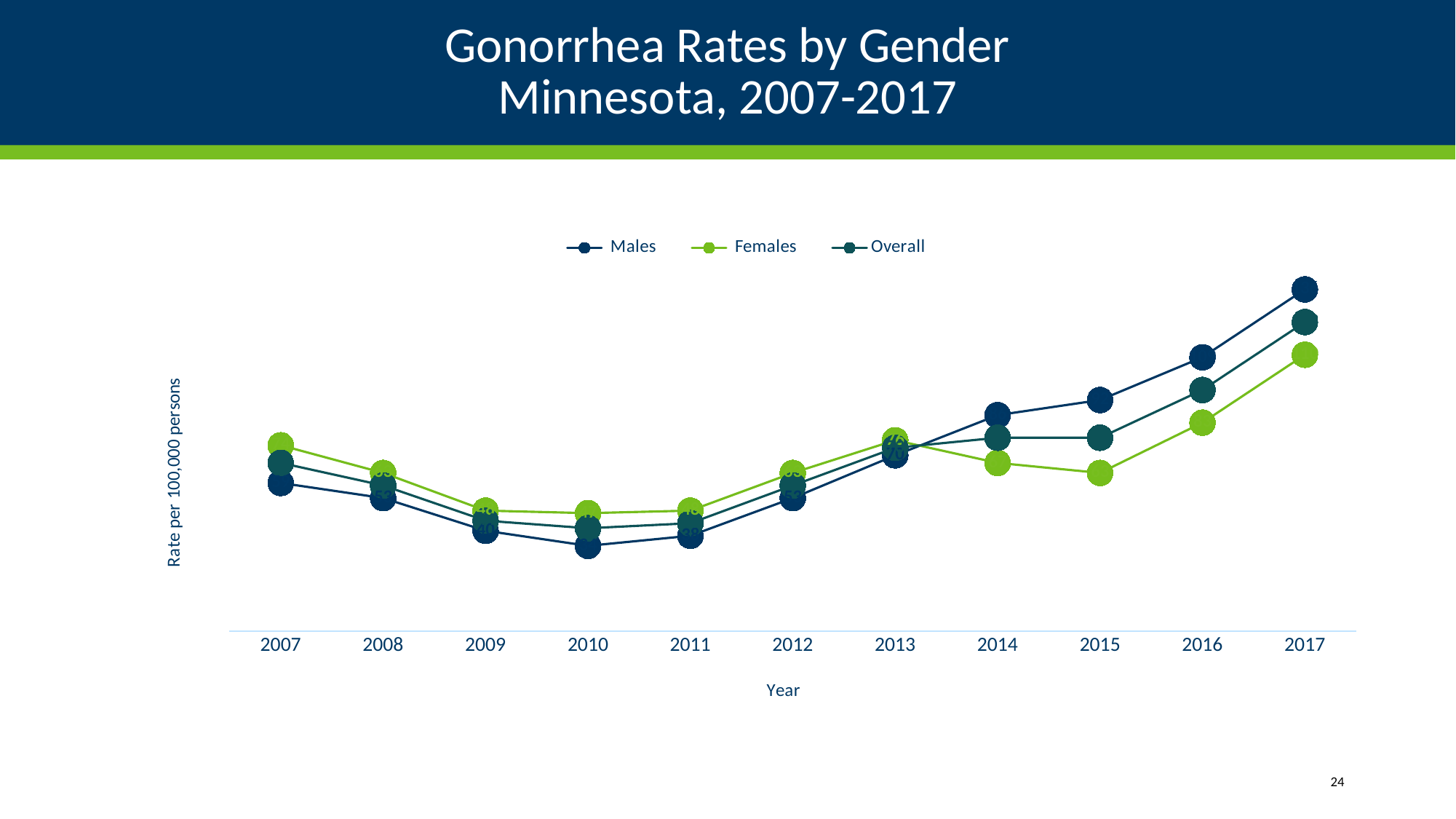
In 2015, which of the three series has the lowest value? Females How many years are plotted along the x axis? 11 In which year does the Males series reach its lowest value? 2010 How many series does the legend list? 3 What is the label on the y axis? Rate per 100,000 persons What kind of chart is shown on the slide? Line chart In which year does the Males series reach its highest value? 2017 Do the Males values rise or fall from 2013 to 2017? Rise In 2017, which series has the higher value, Males or Females? Males In 2007, which series has the higher value, Males or Females? Females Do the Females values rise or fall from 2007 to 2010? Fall In which year does the Females series reach its highest value? 2017